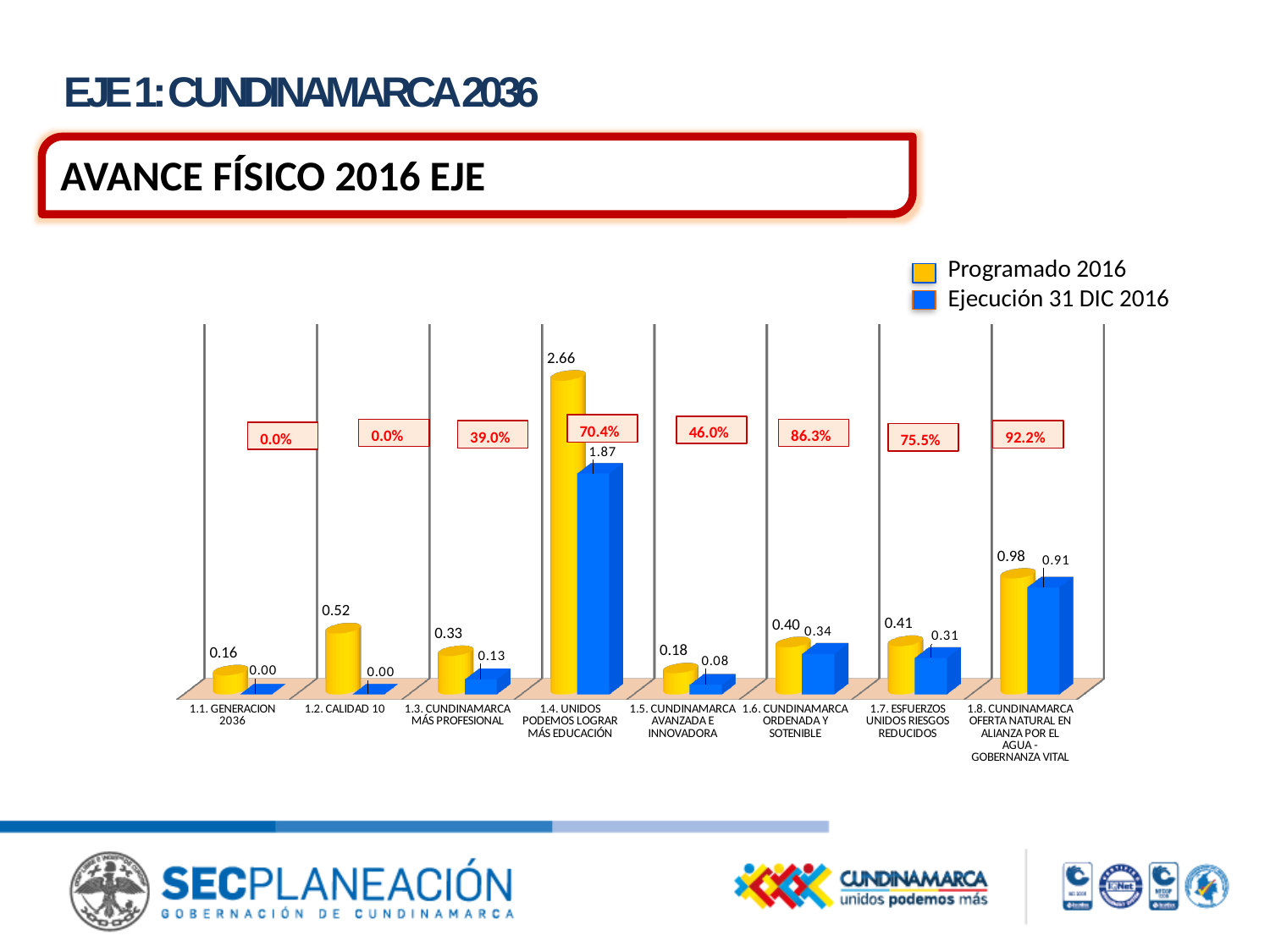
What is the Ejecución 31 DIC 2016 value for 1.2. CALIDAD 10? 0.00 What is the Ejecución 31 DIC 2016 value for 1.8. CUNDINAMARCA OFERTA NATURAL EN ALIANZA POR EL AGUA - GOBERNANZA VITAL? 0.91 What is the difference between the Programado 2016 and Ejecución 31 DIC 2016 values for 1.4. UNIDOS PODEMOS LOGRAR MÁS EDUCACIÓN? 0.79 How many series does the legend list? 2 What percentage is shown above the bars for 1.6. CUNDINAMARCA ORDENADA Y SOTENIBLE? 86.3% What kind of chart is shown on the slide? Bar chart Which category has the highest Programado 2016 value? 1.4. UNIDOS PODEMOS LOGRAR MÁS EDUCACIÓN Which category has the lowest Programado 2016 value? 1.1. GENERACION 2036 Which is larger for 1.7. ESFUERZOS UNIDOS RIESGOS REDUCIDOS: the Programado 2016 value or the Ejecución 31 DIC 2016 value? Programado 2016 What is the Programado 2016 value for 1.4. UNIDOS PODEMOS LOGRAR MÁS EDUCACIÓN? 2.66 How many categories are shown on the x axis of the chart? 8 Which colour represents the Ejecución 31 DIC 2016 series? Blue